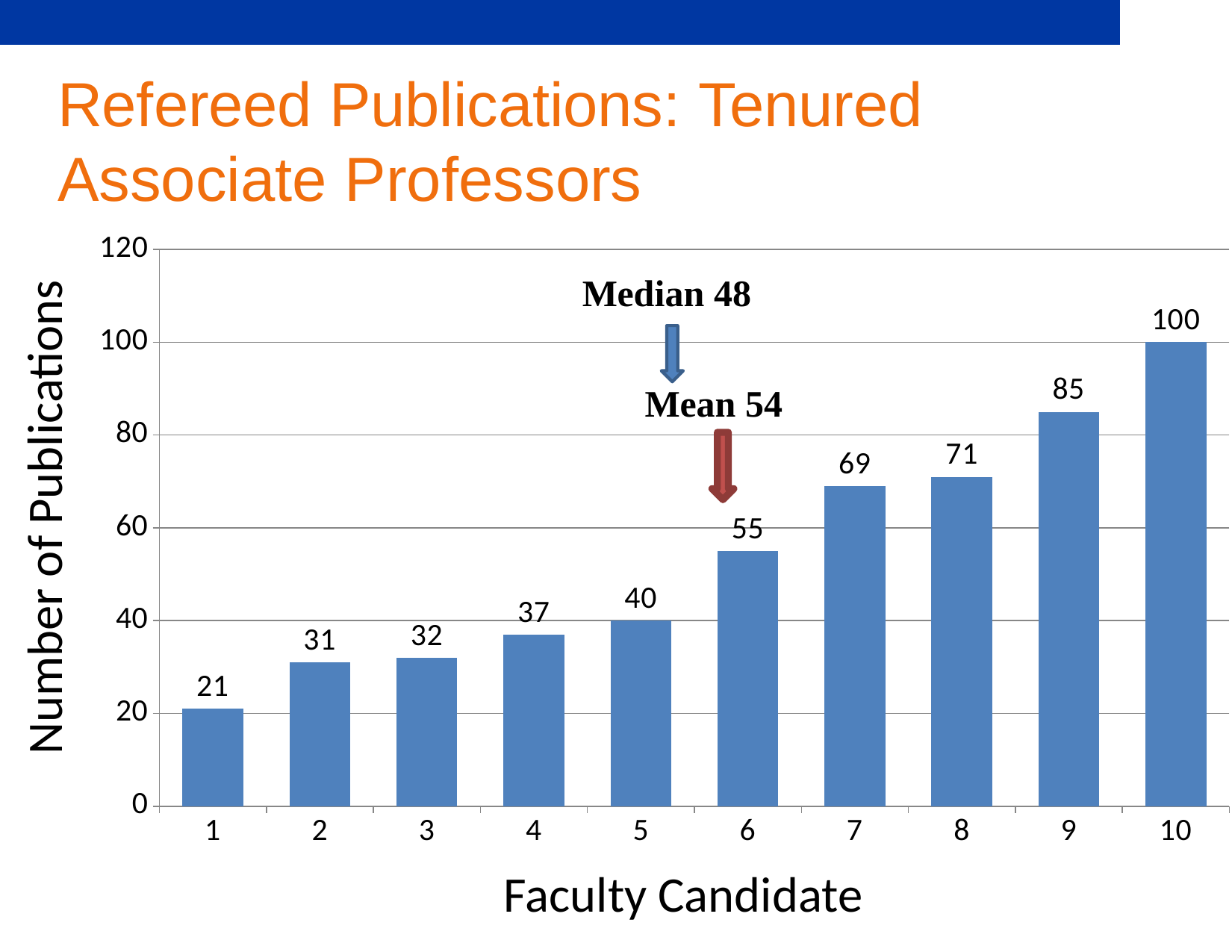
What is the number of publications for Faculty Candidate 1? 21 Do the number of publications rise or fall from Faculty Candidate 1 to Faculty Candidate 10? Rise Who has more publications, Faculty Candidate 7 or Faculty Candidate 8? Faculty Candidate 8 What is the label of the y axis? Number of Publications Is the value for Faculty Candidate 4 greater or less than 40? less Which faculty candidate has the lowest number of publications? 1 What kind of chart is shown on the slide? Bar chart How many faculty candidates are shown on the chart? 10 How many refereed publications does Faculty Candidate 6 have? 55 What median value is annotated on the chart? 48 What is the difference in publications between Faculty Candidate 10 and Faculty Candidate 9? 15 Which faculty candidate has the highest number of publications? 10